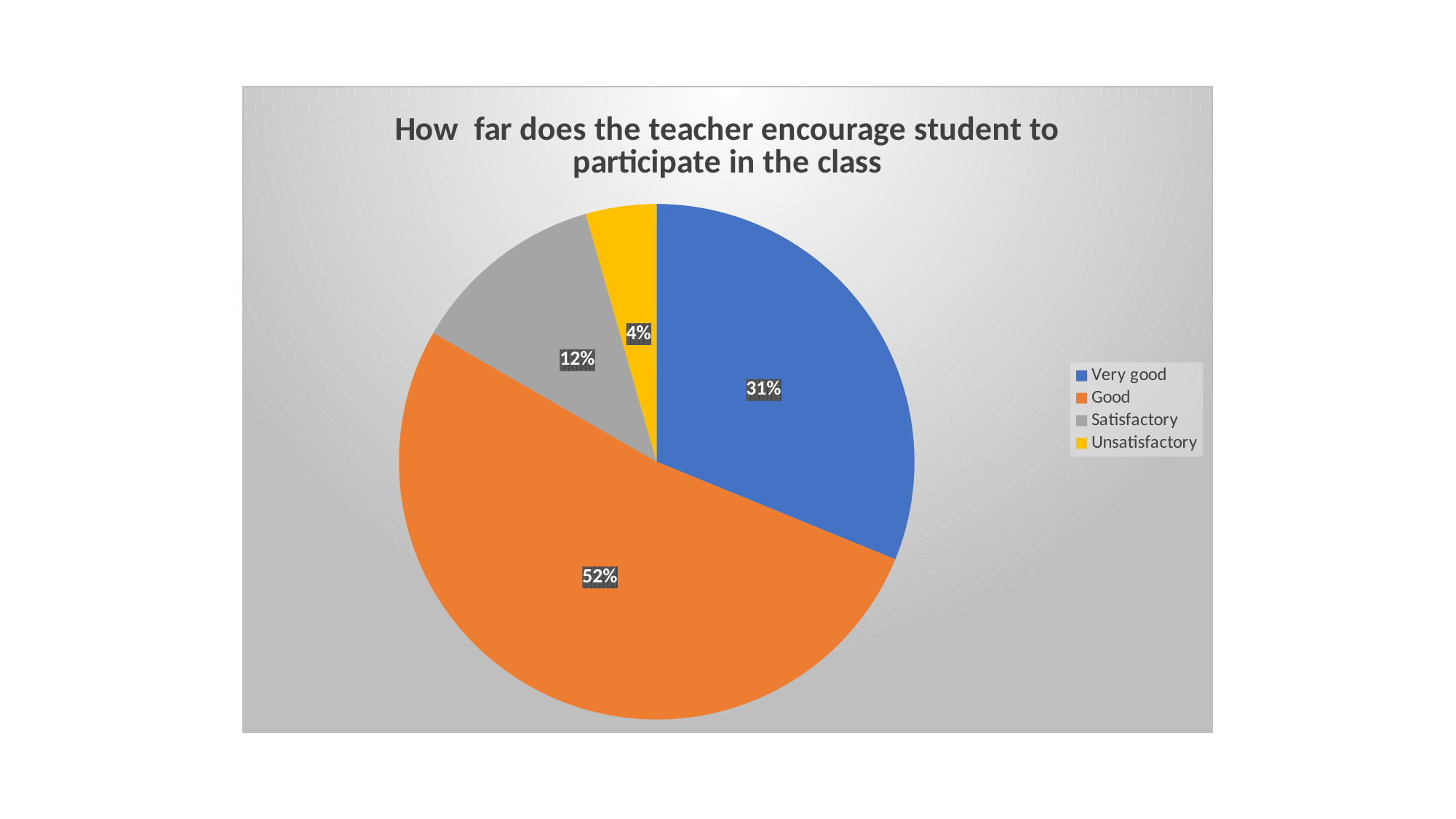
What percentage of responses are 'Satisfactory'? 12% What percentage of responses are 'Very good'? 31% Which category has the largest share of the pie? Good Which colour represents 'Satisfactory' in the legend? grey What kind of chart is shown on the slide? pie chart What percentage of responses are 'Good'? 52% What percentage of responses are 'Unsatisfactory'? 4% Which category has the smallest share of the pie? Unsatisfactory What is the difference in percentage points between 'Good' and 'Very good'? 21 Which is larger, the share for 'Satisfactory' or the share for 'Unsatisfactory'? Satisfactory How many slices does the pie chart have? 4 What is the title of the chart? How far does the teacher encourage student to participate in the class